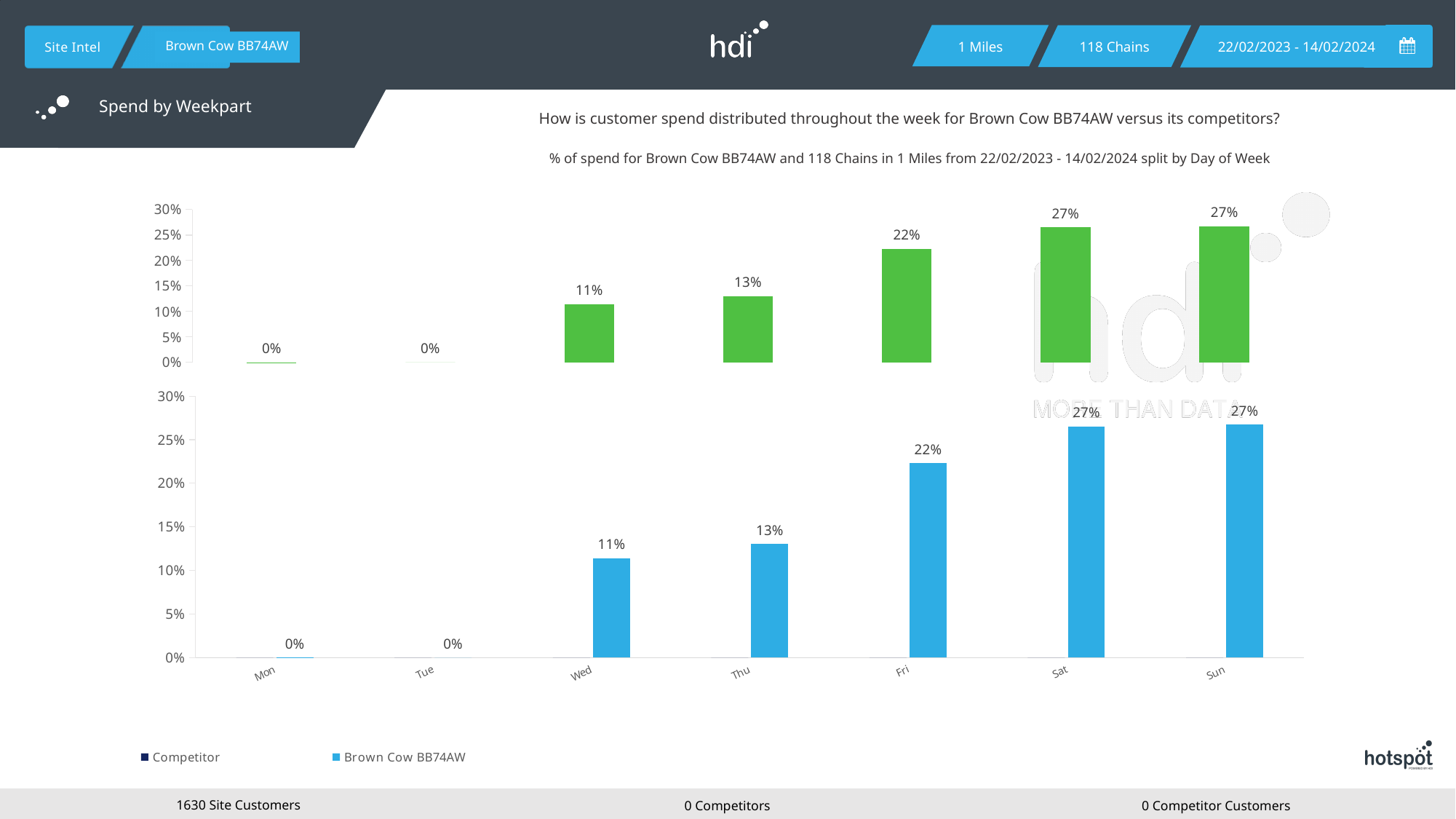
What kind of chart is the bottom chart (Brown Cow BB74AW)? Bar chart In the bottom chart (Brown Cow BB74AW), what is the value for Fri? 22% How many series does the legend list? 2 How many day-of-week categories are shown on the x axis of the bottom chart? 7 In the bottom chart (Brown Cow BB74AW), do the values rise or fall from Wed to Sat? Rise In the bottom chart (Brown Cow BB74AW), what is the value for Thu? 13% In the bottom chart (Brown Cow BB74AW), is the value for Sat greater or less than 25%? greater What colour are the bars for Brown Cow BB74AW in the bottom chart? Blue In the bottom chart (Brown Cow BB74AW), what is the difference between the values for Fri and Thu? 9%